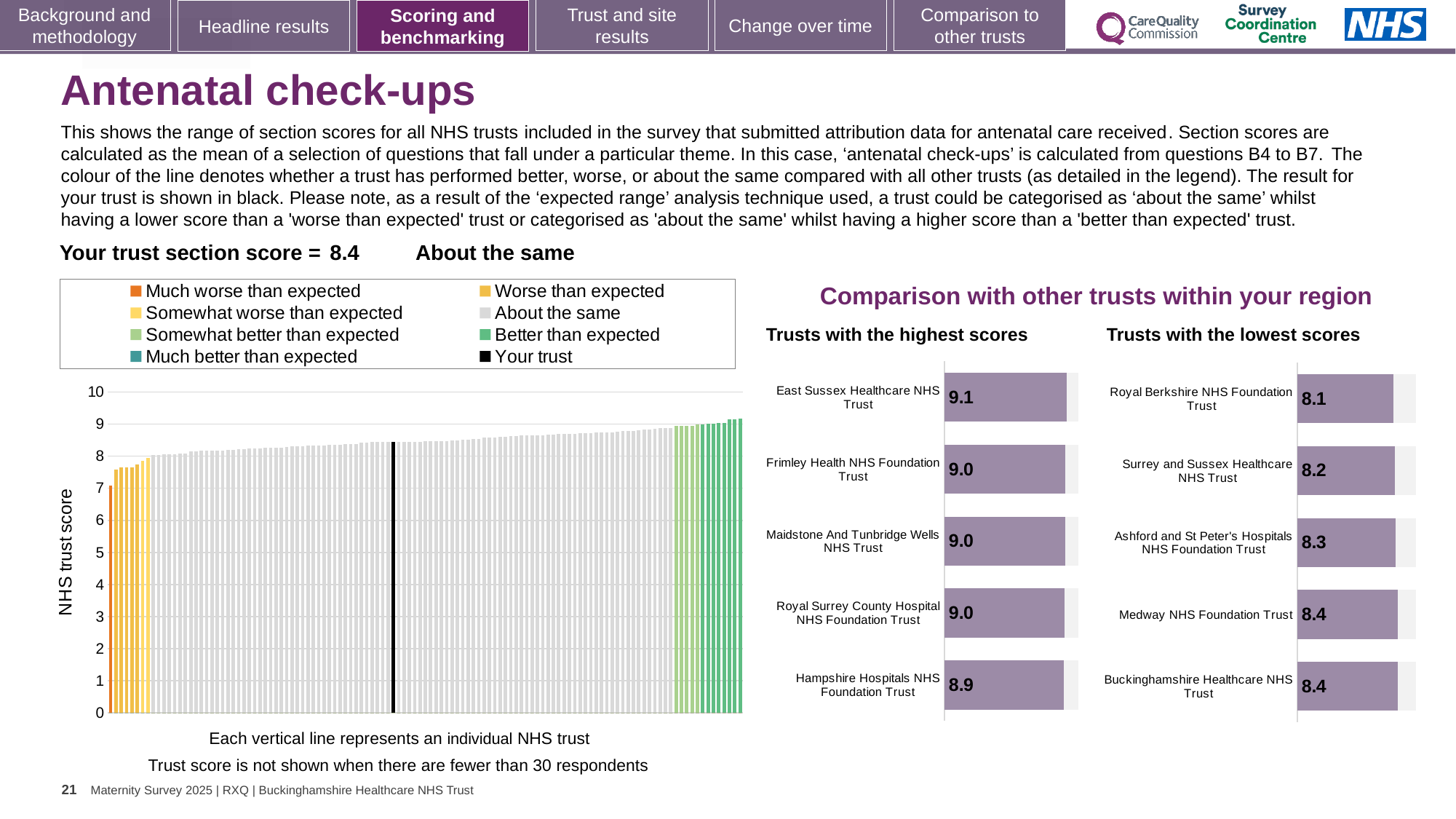
In the 'Trusts with the lowest scores' chart, which has the larger score: Surrey and Sussex Healthcare NHS Trust or Medway NHS Foundation Trust? Medway NHS Foundation Trust How many trusts are listed in the 'Trusts with the lowest scores' chart? 5 In the 'Trusts with the lowest scores' chart, which trust has the lowest score? Royal Berkshire NHS Foundation Trust What kind of chart is the large chart on the left showing NHS trust scores? Bar chart In the 'Trusts with the highest scores' chart, which trust has the lowest score shown? Hampshire Hospitals NHS Foundation Trust How many entries does the legend of the large chart on the left list? 8 In the large chart on the left, is the value of the black 'Your trust' bar greater or less than 8? greater What is the difference between the score for East Sussex Healthcare NHS Trust in the highest-scores chart and the score for Royal Berkshire NHS Foundation Trust in the lowest-scores chart? 1.0 In the 'Trusts with the highest scores' chart, what is the score for East Sussex Healthcare NHS Trust? 9.1 In the 'Trusts with the lowest scores' chart, what is the score for Royal Berkshire NHS Foundation Trust? 8.1 In the 'Trusts with the highest scores' chart, which trust has the highest score? East Sussex Healthcare NHS Trust In the large chart on the left, do the trust scores rise or fall from left to right? Rise